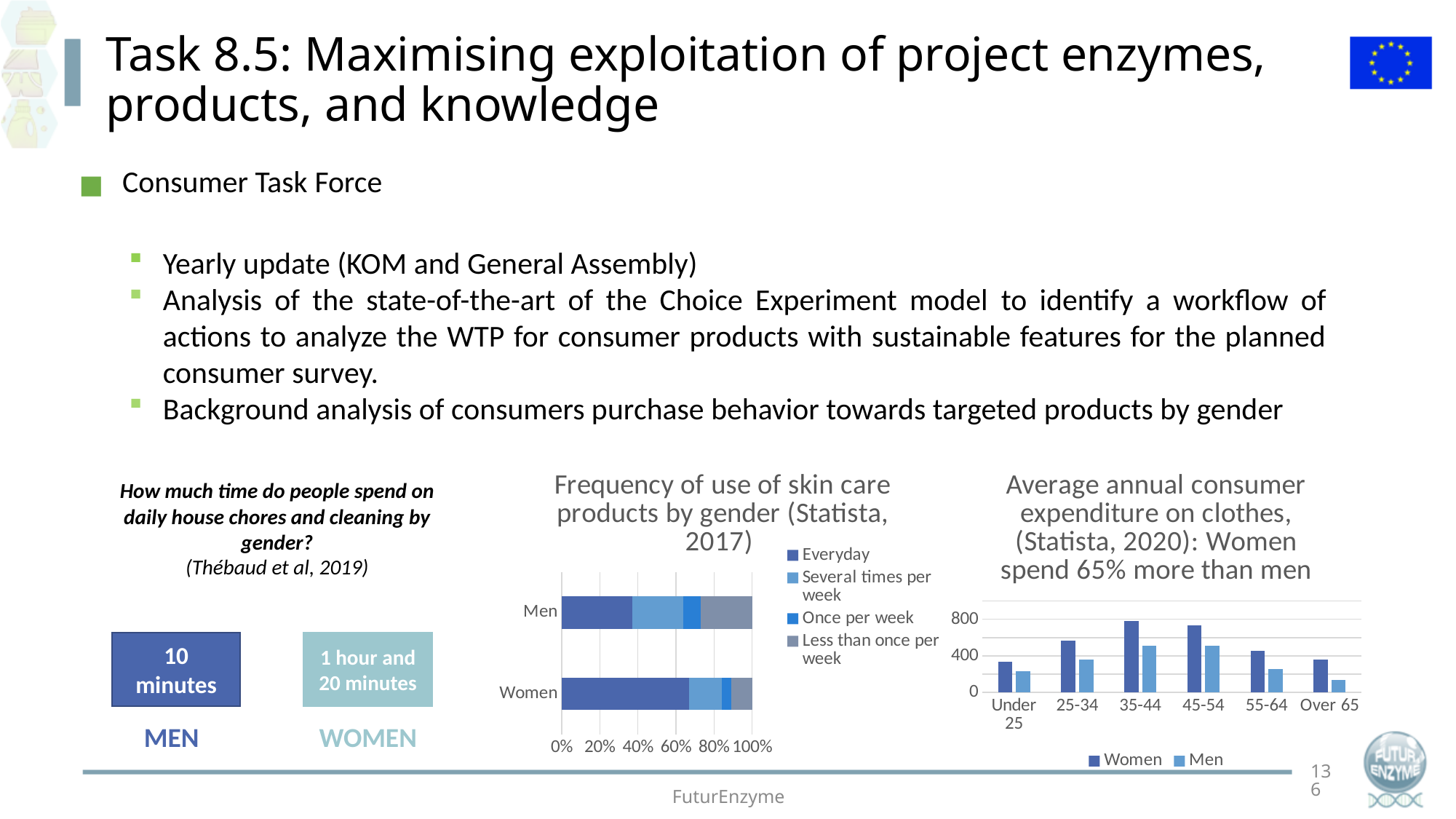
How many age groups are shown on the 'Average annual consumer expenditure on clothes' chart? 6 How many series does the legend of the 'Frequency of use of skin care products by gender' chart list? 4 In the 'Frequency of use of skin care products by gender' chart, which gender has the larger 'Everyday' share, Men or Women? Women In the 'Average annual consumer expenditure on clothes' chart, is the value for Men in the 35-44 age group greater or less than 400? greater What kind of chart is the 'Average annual consumer expenditure on clothes' chart? bar chart In the 'Average annual consumer expenditure on clothes' chart, which age group has the lowest value for Men? Over 65 How many categories are shown on the 'Frequency of use of skin care products by gender' chart? 2 How many series does the legend of the 'Average annual consumer expenditure on clothes' chart list? 2 In the 'Average annual consumer expenditure on clothes' chart, which age group has the highest value for Women? 35-44 In the 'Frequency of use of skin care products by gender' chart, is the 'Everyday' share for Women greater or less than 60%? greater What kind of chart is the 'Frequency of use of skin care products by gender' chart? bar chart